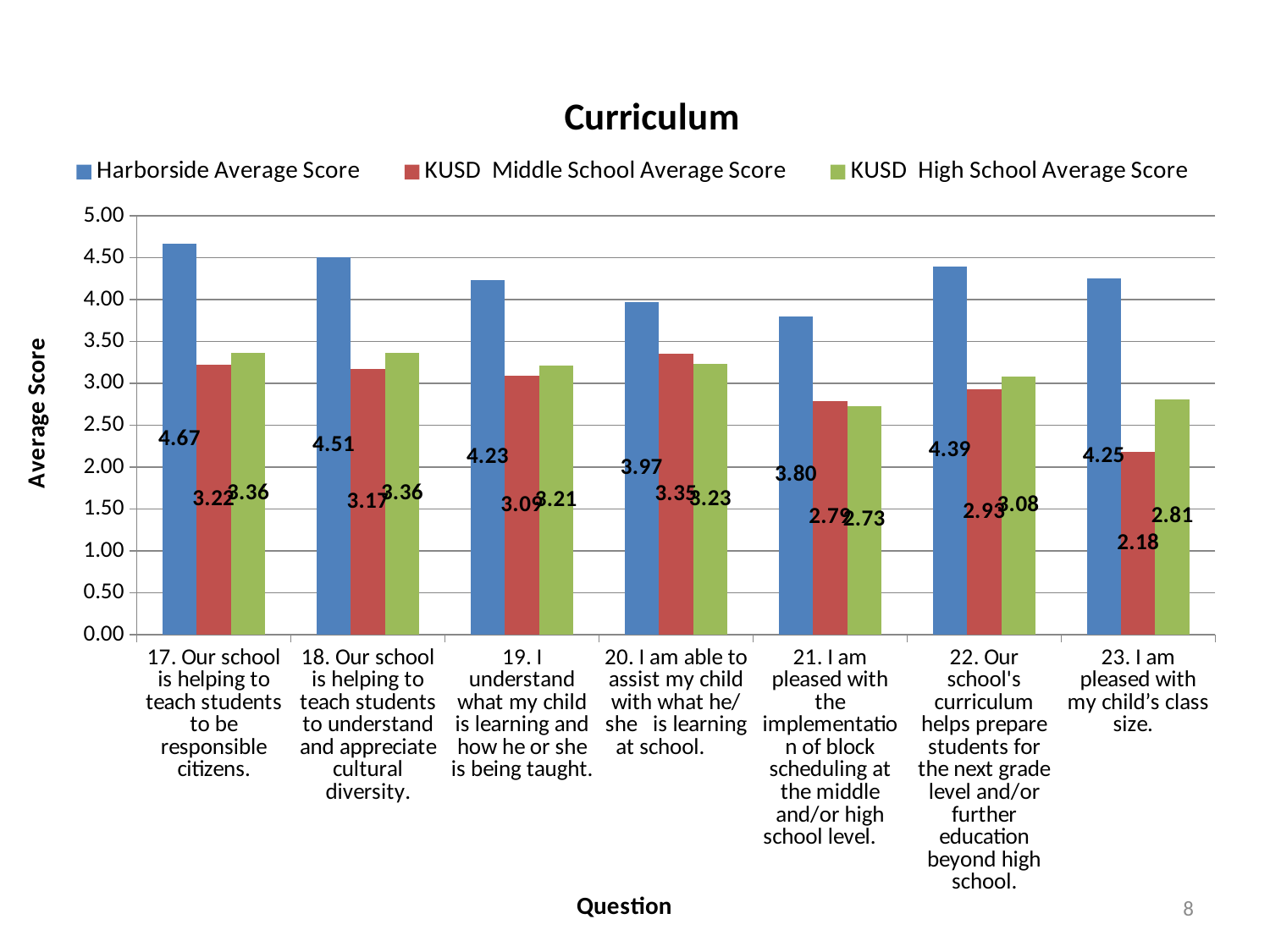
What is the Harborside Average Score for question 21 (I am pleased with the implementation of block scheduling)? 3.80 What is the difference between the Harborside Average Score for question 17 and for question 21? 0.87 Is the Harborside Average Score for question 22 greater or less than 4.00? greater How many series does the legend list? 3 What is the KUSD High School Average Score for question 23 (I am pleased with my child's class size)? 2.81 Which question has the lowest Harborside Average Score? 21. I am pleased with the implementation of block scheduling at the middle and/or high school level. What is the KUSD Middle School Average Score for question 23 (I am pleased with my child's class size)? 2.18 For question 23, which is larger: the KUSD Middle School Average Score or the KUSD High School Average Score? KUSD High School Average Score How many questions (categories) are shown on the x axis of the chart? 7 What kind of chart is shown on the slide? bar chart Which question has the highest Harborside Average Score? 17. Our school is helping to teach students to be responsible citizens. What is the Harborside Average Score for question 17 (Our school is helping to teach students to be responsible citizens)? 4.67